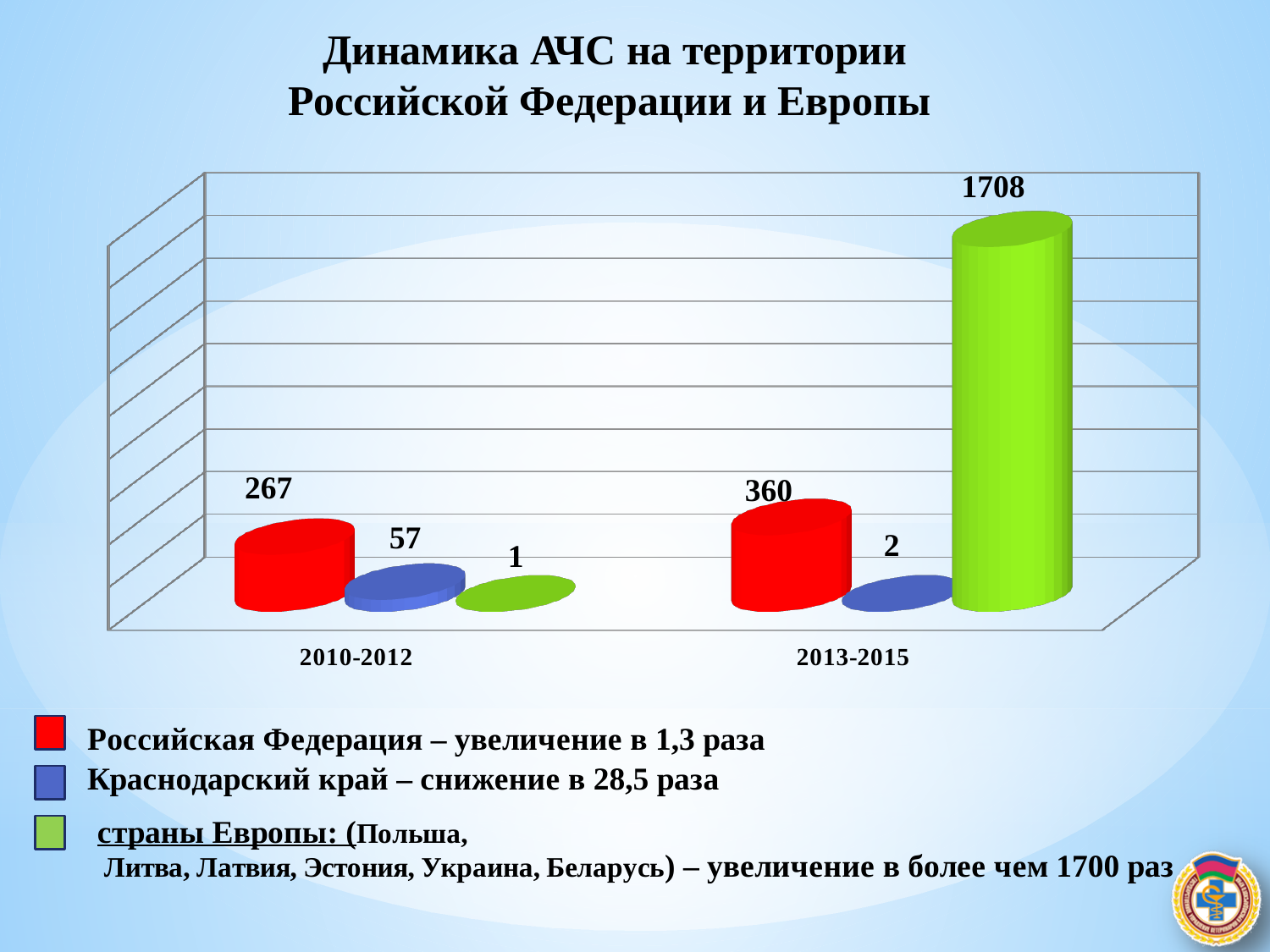
What is the value for страны Европы in 2010-2012? 1 How many series does the legend list? 3 How many period categories are shown on the x axis? 2 What is the difference between the Российская Федерация values for 2013-2015 and 2010-2012? 93 What kind of chart is shown on the slide? bar chart Which series has the highest value in 2013-2015? страны Европы Which is larger: Российская Федерация in 2010-2012 or Российская Федерация in 2013-2015? 2013-2015 What is the value for страны Европы in 2013-2015? 1708 What is the value for Краснодарский край in 2013-2015? 2 What is the value for Российская Федерация in 2010-2012? 267 Which series has the lowest value in 2010-2012? страны Европы What is the difference between the Краснодарский край values for 2010-2012 and 2013-2015? 55